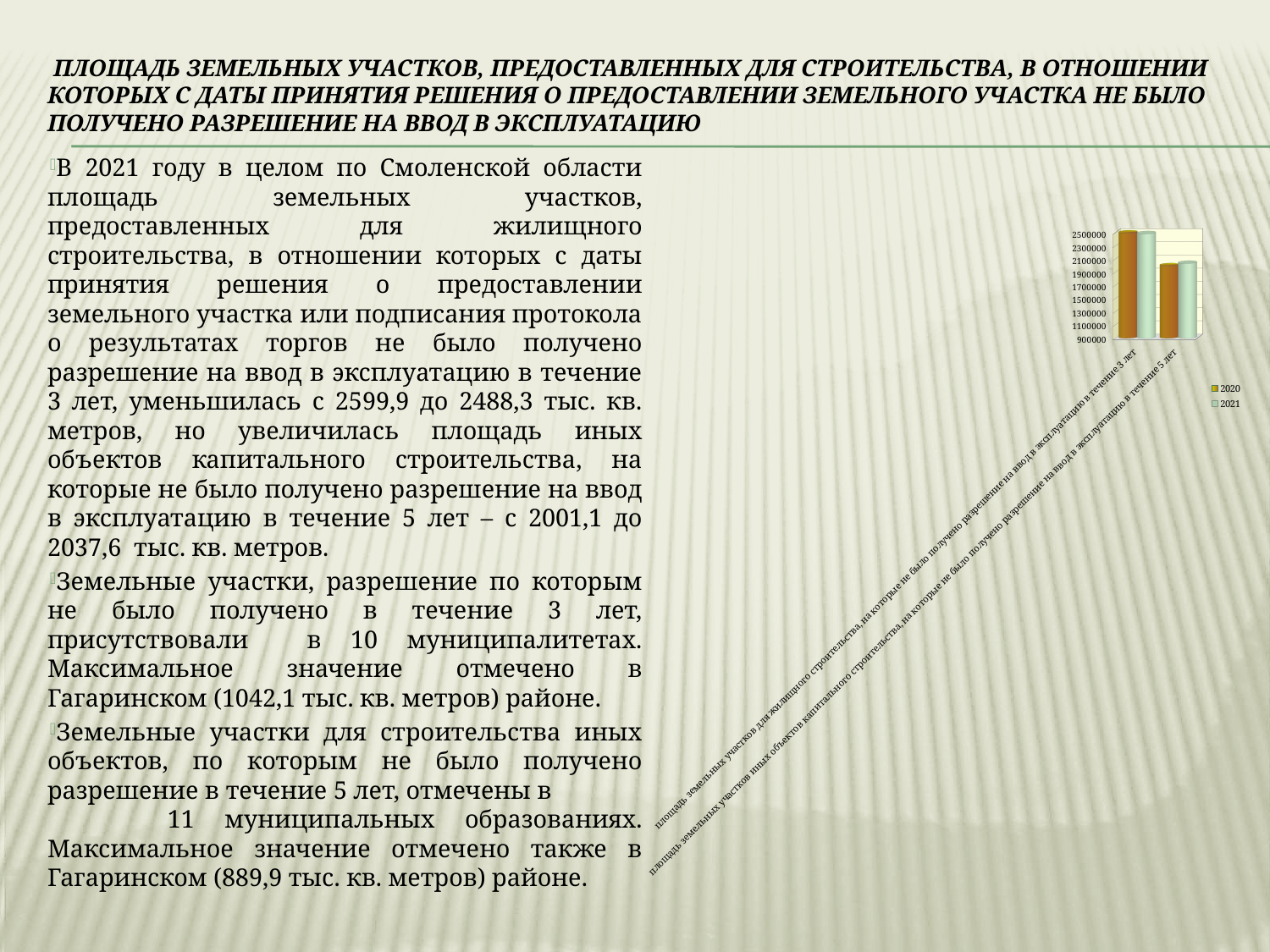
Is the 2021 value for the other capital construction objects (5 years) category greater or less than 1900000? greater Which category has the taller bars: the land plots for housing construction (3 years) or the land plots for other capital construction objects (5 years)? land plots for housing construction (3 years) Is the 2020 value for the housing construction (3 years) category greater or less than 2300000? greater How many series does the chart legend list? 2 What kind of chart is shown on the slide? bar chart What is the highest tick value shown on the chart's vertical axis? 2500000 Is the 2020 value for the other capital construction objects (5 years) category greater or less than 2300000? less How many categories are plotted on the chart's x axis? 2 Do the bar values rise or fall from the first category to the second category along the x axis? fall For the housing construction (3 years) category, which bar is taller, 2020 or 2021? 2020 Which years are listed in the chart legend? 2020 and 2021